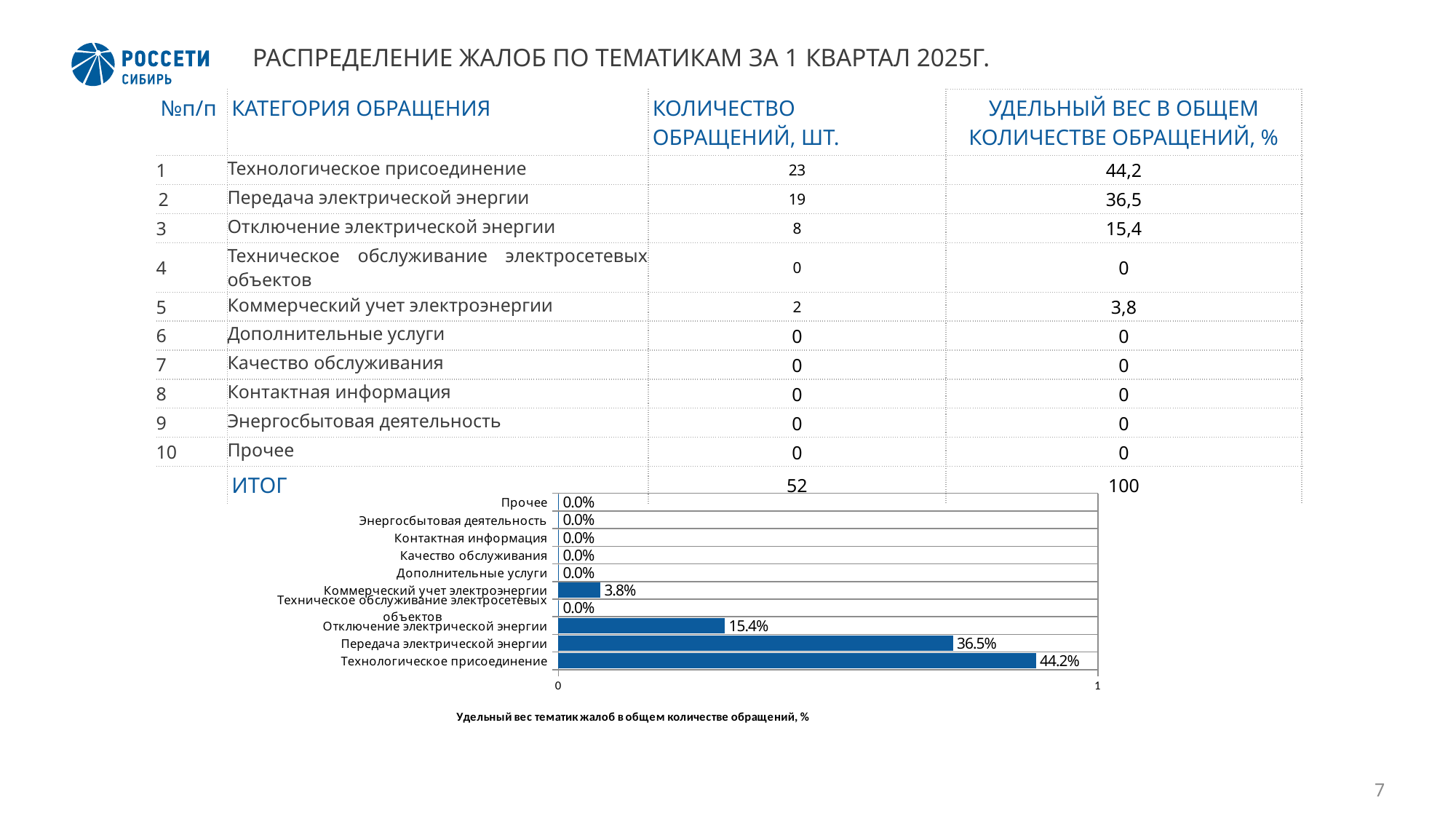
What is the value for Отключение электрической энергии in the bar chart? 15.4% How many categories are shown in the bar chart? 10 What is the legend entry shown below the bar chart? Удельный вес тематик жалоб в общем количестве обращений, % What type of chart is shown on the slide? bar chart What is the value for Технологическое присоединение in the bar chart? 44.2% Which is larger in the bar chart: the value for Отключение электрической энергии or the value for Коммерческий учет электроэнергии? Отключение электрической энергии What is the value for Коммерческий учет электроэнергии in the bar chart? 3.8% What is the difference between the values for Отключение электрической энергии and Коммерческий учет электроэнергии in the bar chart? 11.6% What is the value for Передача электрической энергии in the bar chart? 36.5% What is the difference between the values for Технологическое присоединение and Передача электрической энергии in the bar chart? 7.7% What is the value for Прочее in the bar chart? 0.0% Which category has the highest value in the bar chart? Технологическое присоединение